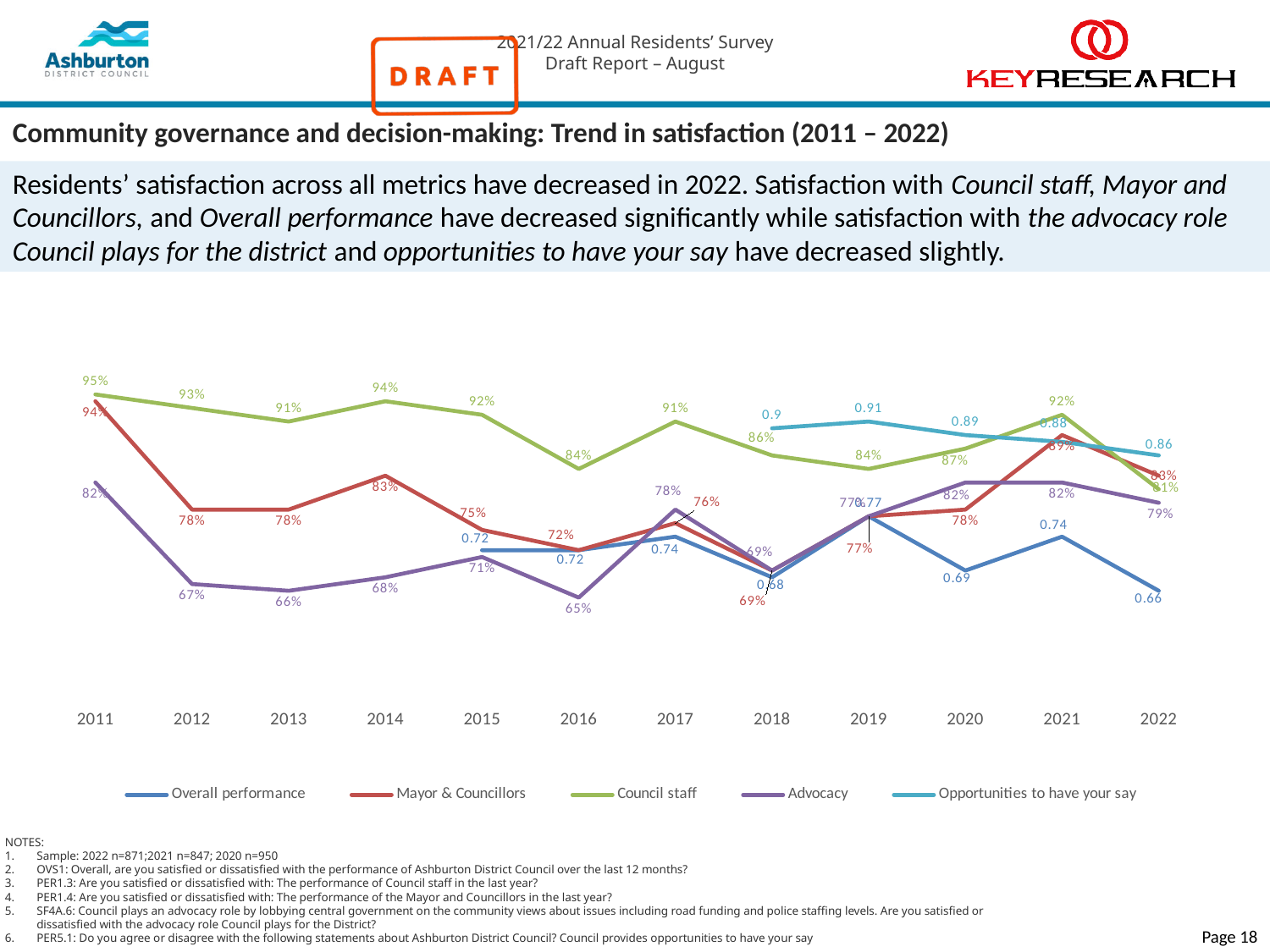
In which year is the Overall performance series at its lowest? 2022 What is the Advocacy satisfaction value for 2016? 65% How many years are shown along the x axis of the chart? 12 What type of chart is shown on the slide? Line chart In which year is the Council staff series at its highest? 2011 What is the Council staff satisfaction value for 2022? 81% What is the Mayor & Councillors satisfaction value for 2021? 89% What is the Overall performance value for 2022? 0.66 What is the Council staff satisfaction value for 2011? 95% By how many percentage points did Council staff satisfaction fall from 2011 to 2022? 14 percentage points What is the Opportunities to have your say value for 2019? 0.91 How many series does the chart legend list? 5